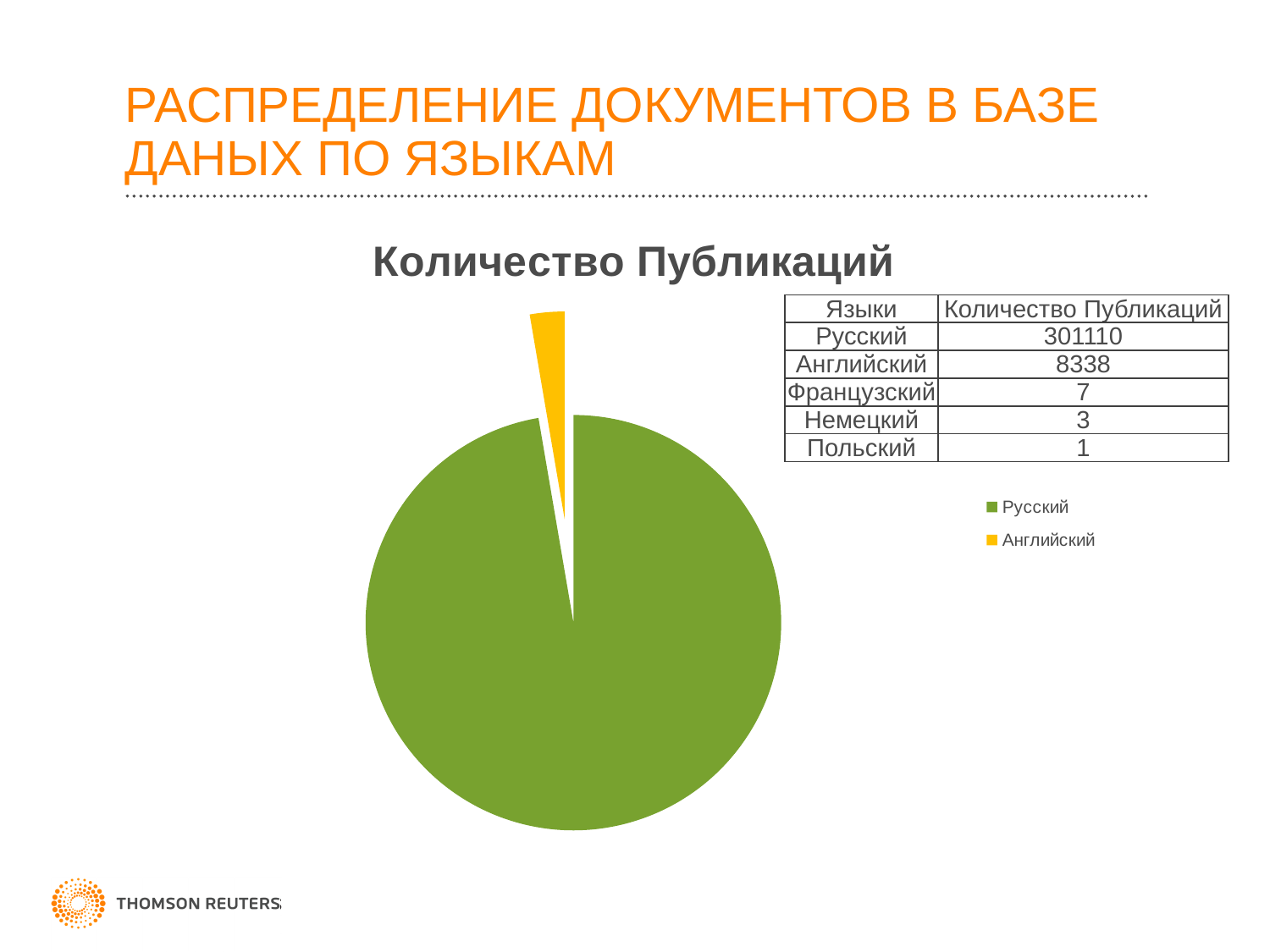
What colour is the slice for Английский in the pie chart? yellow According to the table, how many publications are in Английский? 8338 What is the title of the chart? Количество Публикаций Which has more publications, Немецкий or Французский? Французский How many languages are listed in the table? 5 Which language has the largest slice of the pie? Русский What is the difference in publications between Русский and Английский? 292772 According to the table, how many publications are in Французский? 7 According to the table, which language has the fewest publications? Польский According to the table, how many publications are in Русский? 301110 How many entries does the chart legend list? 2 What type of chart is shown on the slide? pie chart